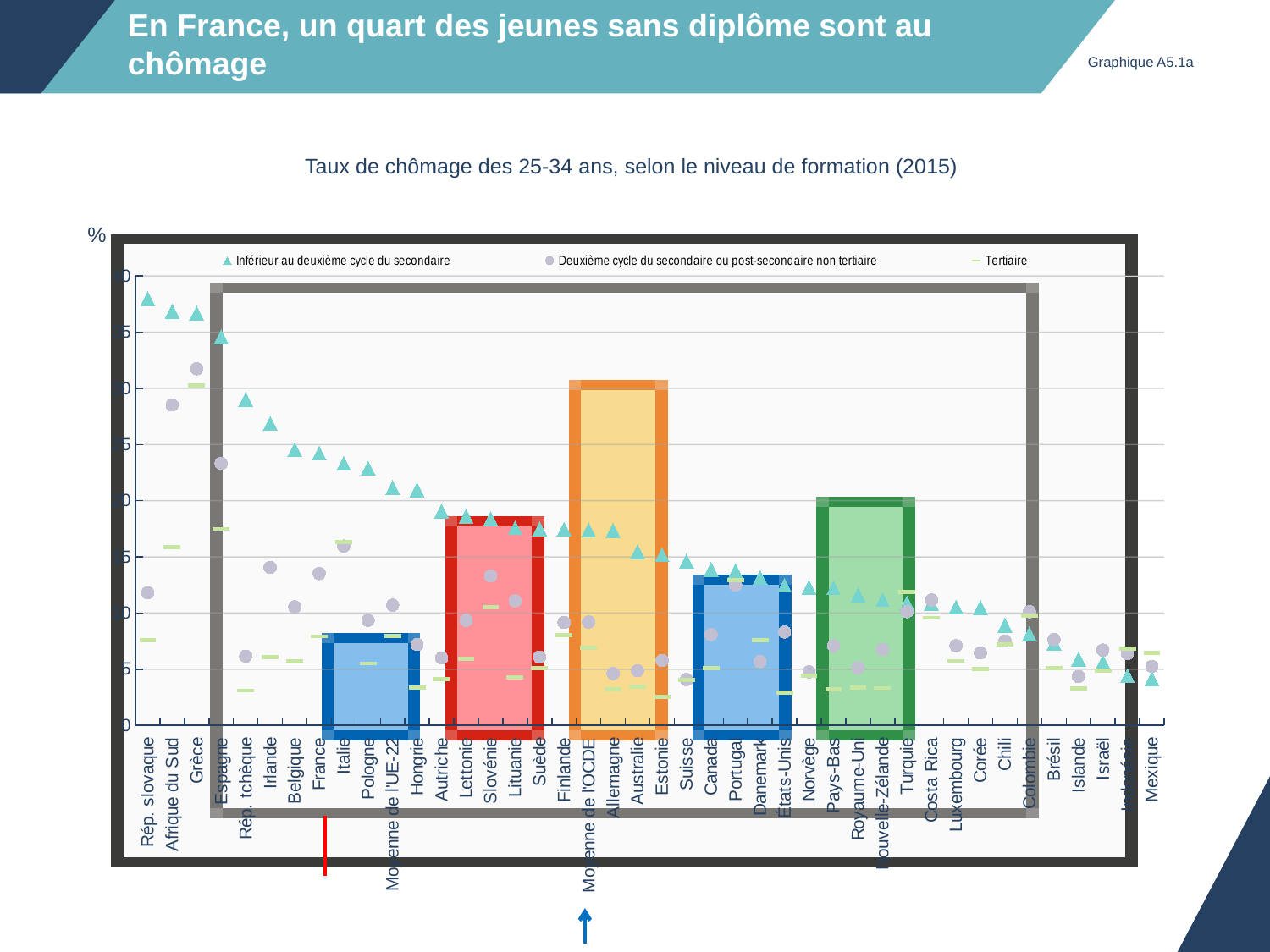
For Corée, which is higher: the 'Inférieur au deuxième cycle du secondaire' value or the 'Deuxième cycle du secondaire ou post-secondaire non tertiaire' value? Inférieur au deuxième cycle du secondaire What kind of chart is shown on the slide? Scatter (marker) chart Which country has the highest value for the series 'Inférieur au deuxième cycle du secondaire'? Rép. slovaque For the series 'Deuxième cycle du secondaire ou post-secondaire non tertiaire', which is higher: Grèce or Espagne? Grèce For the series 'Inférieur au deuxième cycle du secondaire', which is higher: Allemagne or Suisse? Allemagne Which series is plotted with triangle markers? Inférieur au deuxième cycle du secondaire Do the values for 'Inférieur au deuxième cycle du secondaire' generally rise or fall from left to right along the x axis? Fall Which country has the lowest value for the series 'Inférieur au deuxième cycle du secondaire'? Mexique What is the title of the chart? Taux de chômage des 25-34 ans, selon le niveau de formation (2015) How many series does the legend list? 3